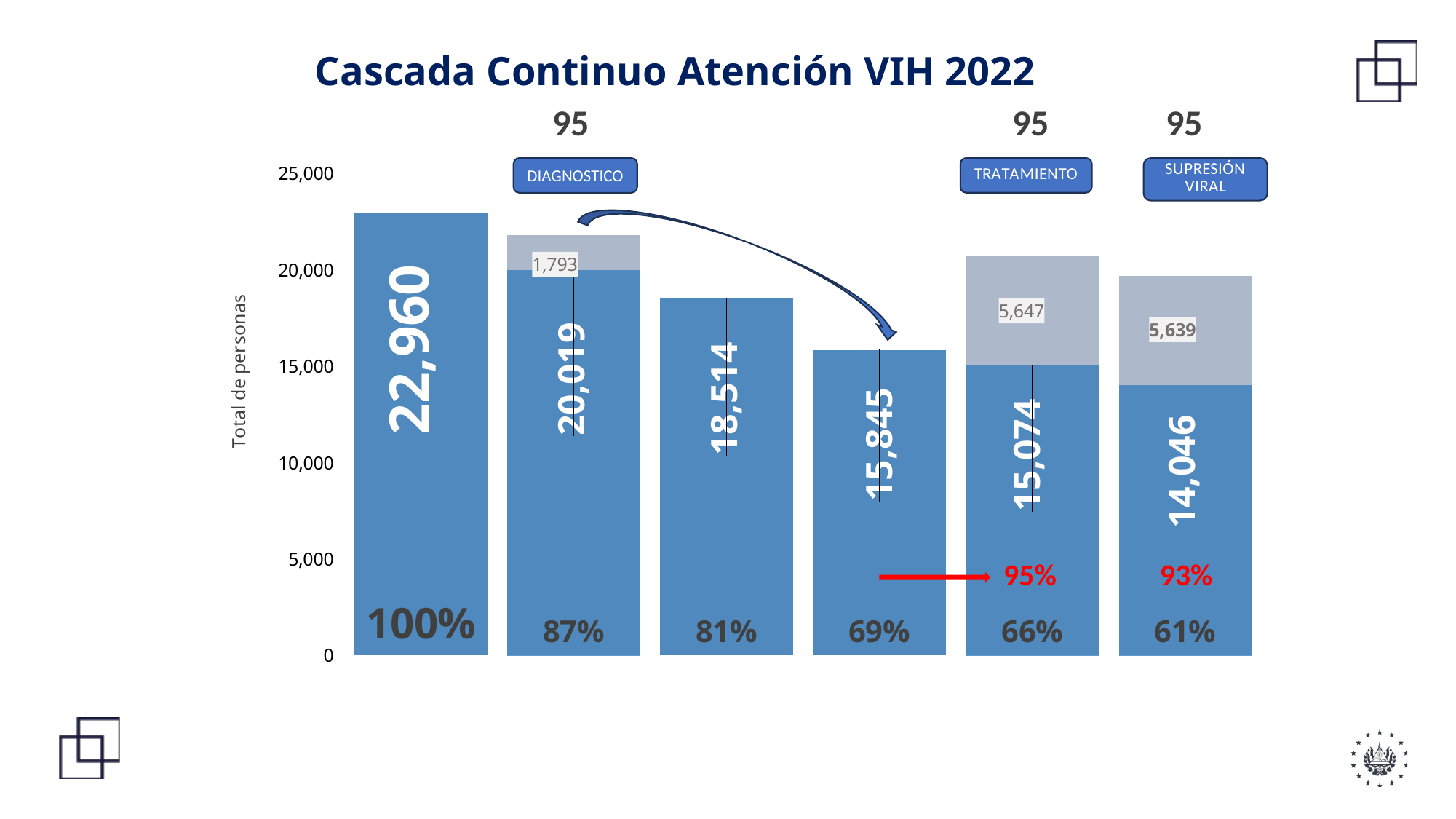
What value is printed on the dark blue part of the bar under the DIAGNOSTICO label? 20,019 What percentage is printed at the bottom of the bar under the TRATAMIENTO label? 66% What is the title of the chart? Cascada Continuo Atención VIH 2022 Do the dark blue bar values rise or fall from left to right across the chart? fall What value is printed on the dark blue part of the bar under the SUPRESIÓN VIRAL label? 14,046 Which bar has the highest value in the chart? the first (leftmost) bar, 22,960 What type of chart is shown on the slide? bar chart What is the total of the TRATAMIENTO bar, adding the dark blue value 15,074 and the grey segment 5,647? 20,721 What is the difference between the first bar (22,960) and the dark blue value of the DIAGNOSTICO bar (20,019)? 2,941 How many bars are plotted in the chart? 6 What is the label of the vertical axis? Total de personas What value is printed on the first (leftmost) bar of the chart? 22,960